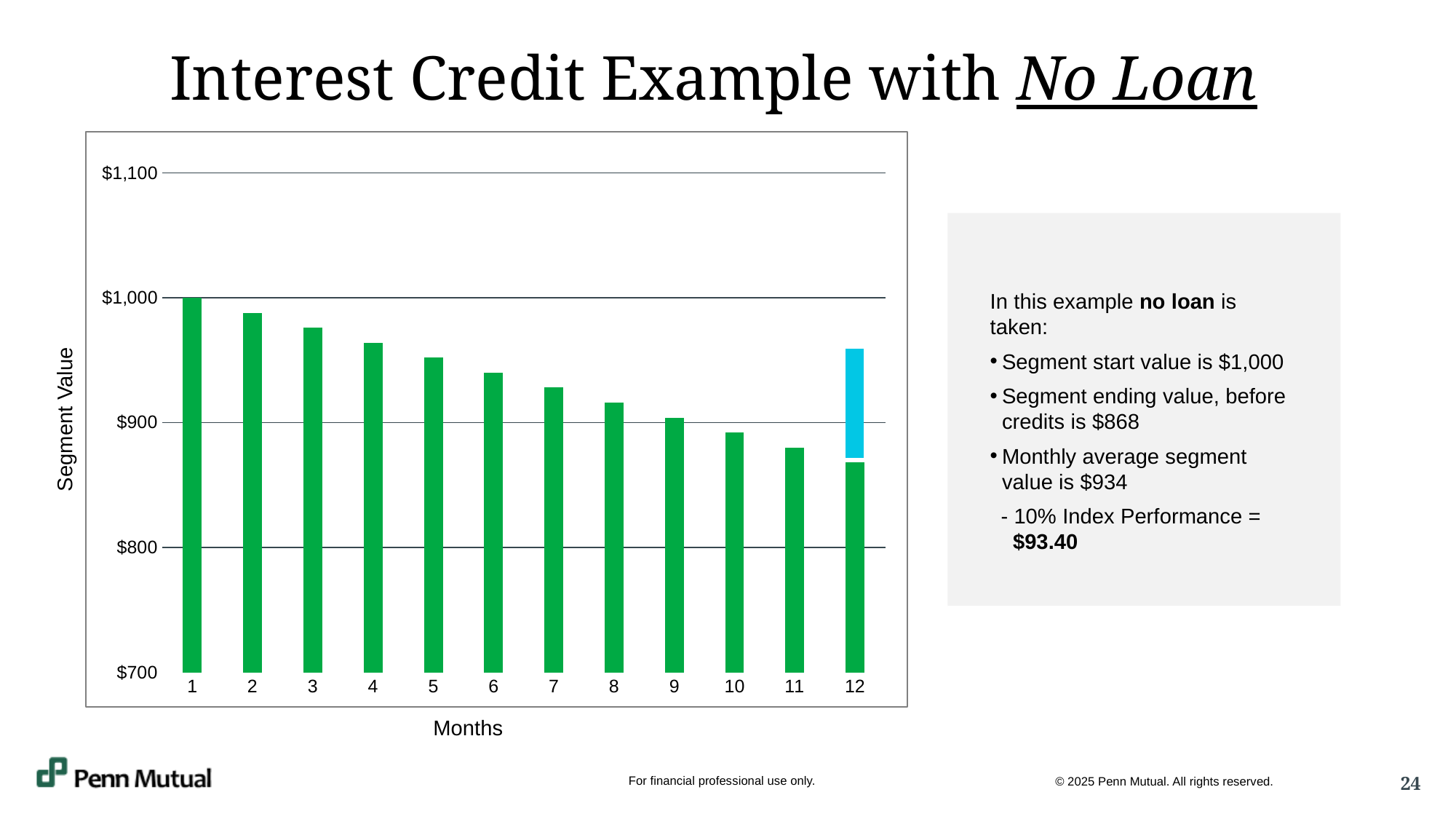
What kind of chart is shown on the slide? Bar chart How many months are plotted on the x axis of the chart? 12 Is the segment value for month 11 greater or less than $900? less Which month has the highest segment value? 1 What is the title of the vertical axis of the chart? Segment Value Which month has the lowest green bar (segment value before credits)? 12 Is the segment value for month 3 greater or less than $1,000? less Is the segment value for month 6 greater or less than $900? greater What is the segment value for month 1? $1,000 What colour is the extra bar segment stacked on top of month 12? Blue Do the green bars rise or fall from month 1 to month 12? Fall Which is larger, the segment value for month 2 or for month 7? Month 2